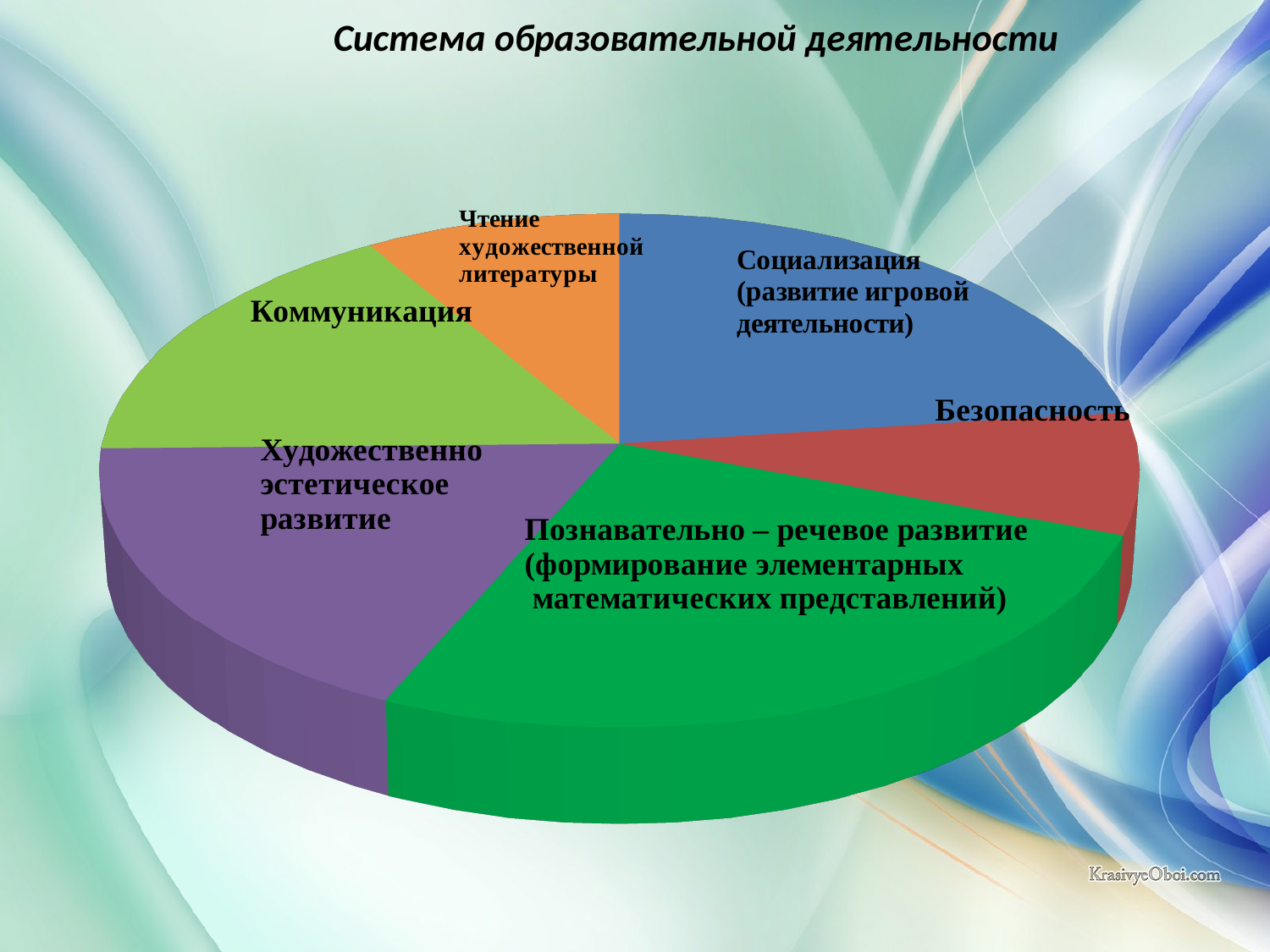
Which slice is larger: Коммуникация or Чтение художественной литературы? Коммуникация Which slice is larger: Художественно эстетическое развитие or Чтение художественной литературы? Художественно эстетическое развитие What is the title of the slide with the pie chart? Система образовательной деятельности What colour is the Безопасность slice of the pie chart? red Which slice is larger: Познавательно – речевое развитие or Безопасность? Познавательно – речевое развитие What kind of chart is shown on the slide? pie chart Which slice of the pie chart is the largest? Познавательно – речевое развитие (формирование элементарных математических представлений) How many slices does the pie chart have? 6